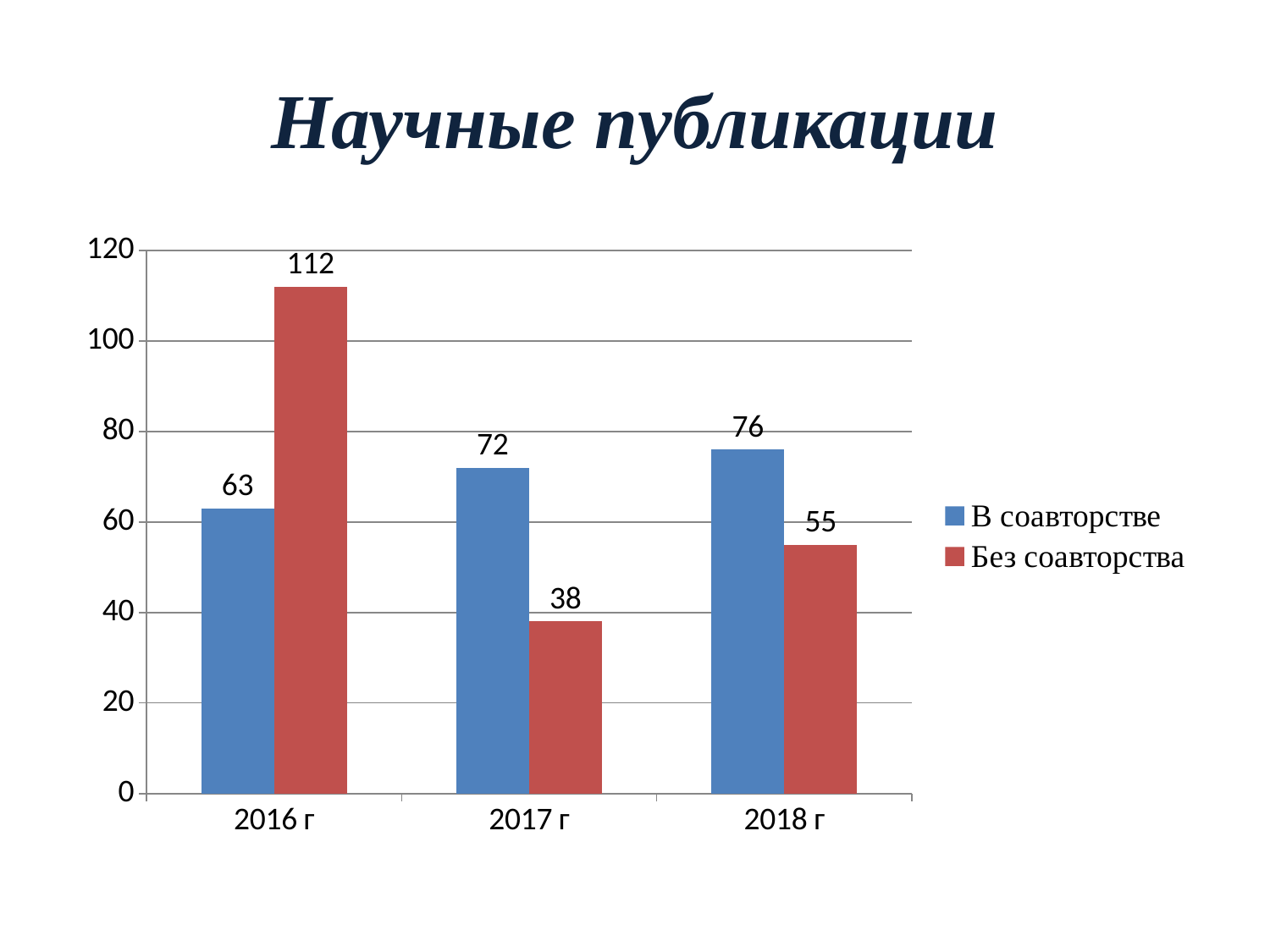
What kind of chart is shown on the slide? bar chart What is the value for "В соавторстве" in 2016 г? 63 How many years are shown on the x axis? 3 Is the value for "Без соавторства" in 2016 г greater or less than 100? greater How many series does the legend list? 2 Which is larger in 2017 г: "В соавторстве" or "Без соавторства"? В соавторстве Does the value for "В соавторстве" rise or fall from 2016 г to 2018 г? rise In which year is the value for "В соавторстве" lowest? 2016 г What is the difference between "Без соавторства" and "В соавторстве" in 2016 г? 49 What is the value for "Без соавторства" in 2018 г? 55 What is the value for "Без соавторства" in 2017 г? 38 In which year is the value for "Без соавторства" highest? 2016 г